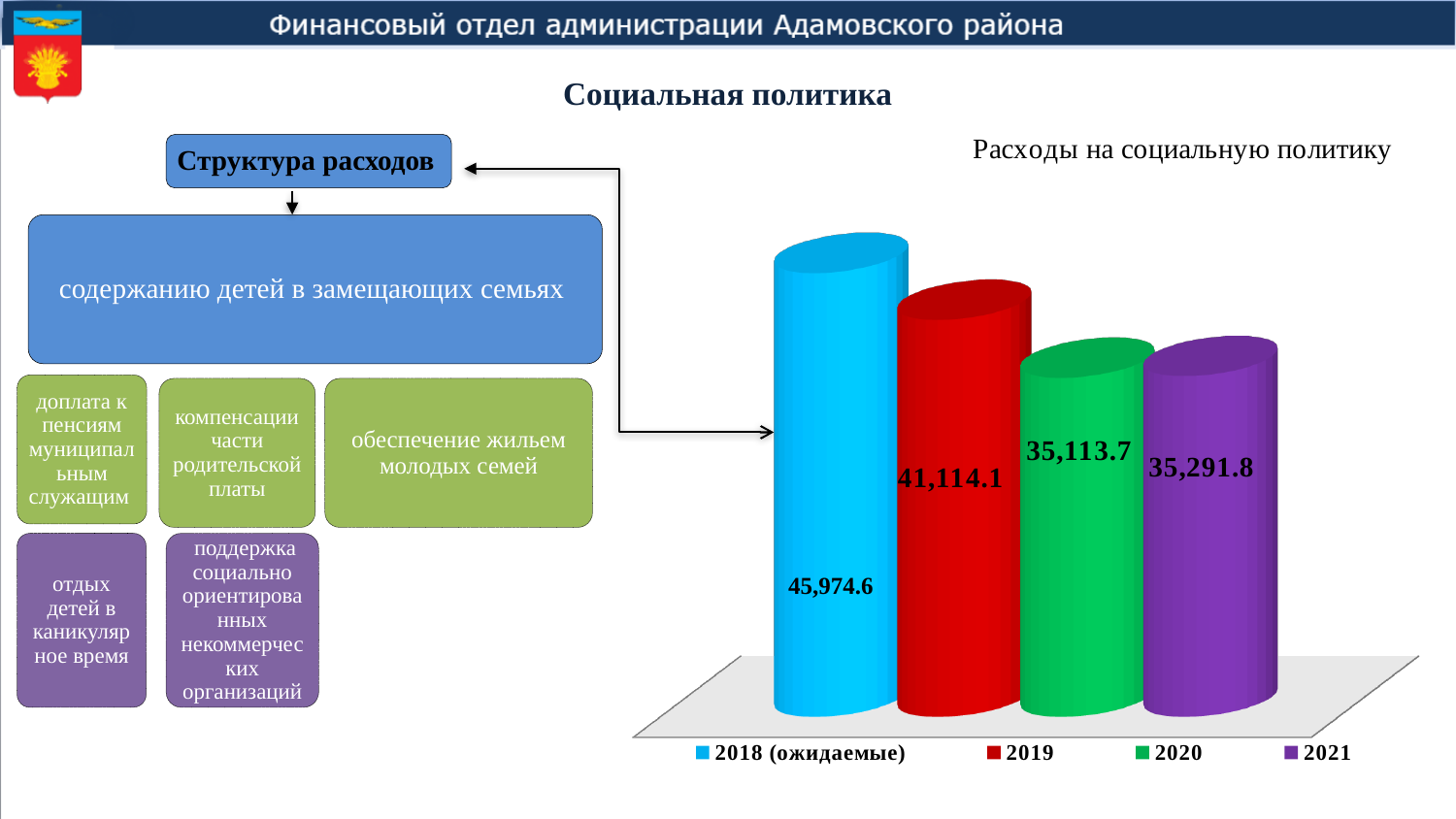
How many series does the legend of the chart list? 4 Which is larger, the value for 2019 or the value for 2021? 2019 Do the values rise or fall from 2018 (ожидаемые) to 2020? Fall What is the value shown for 2021 in the chart? 35,291.8 What is the difference between the values for 2018 (ожидаемые) and 2019? 4,860.5 Which year has the lowest value in the chart? 2020 Which year has the highest value in the chart? 2018 (ожидаемые) What is the value shown for 2018 (ожидаемые) in the chart? 45,974.6 What is the value shown for 2019 in the chart 'Расходы на социальную политику'? 41,114.1 What kind of chart is used to show 'Расходы на социальную политику'? Bar chart What is the difference between the values for 2021 and 2020? 178.1 What is the value shown for 2020 in the chart? 35,113.7